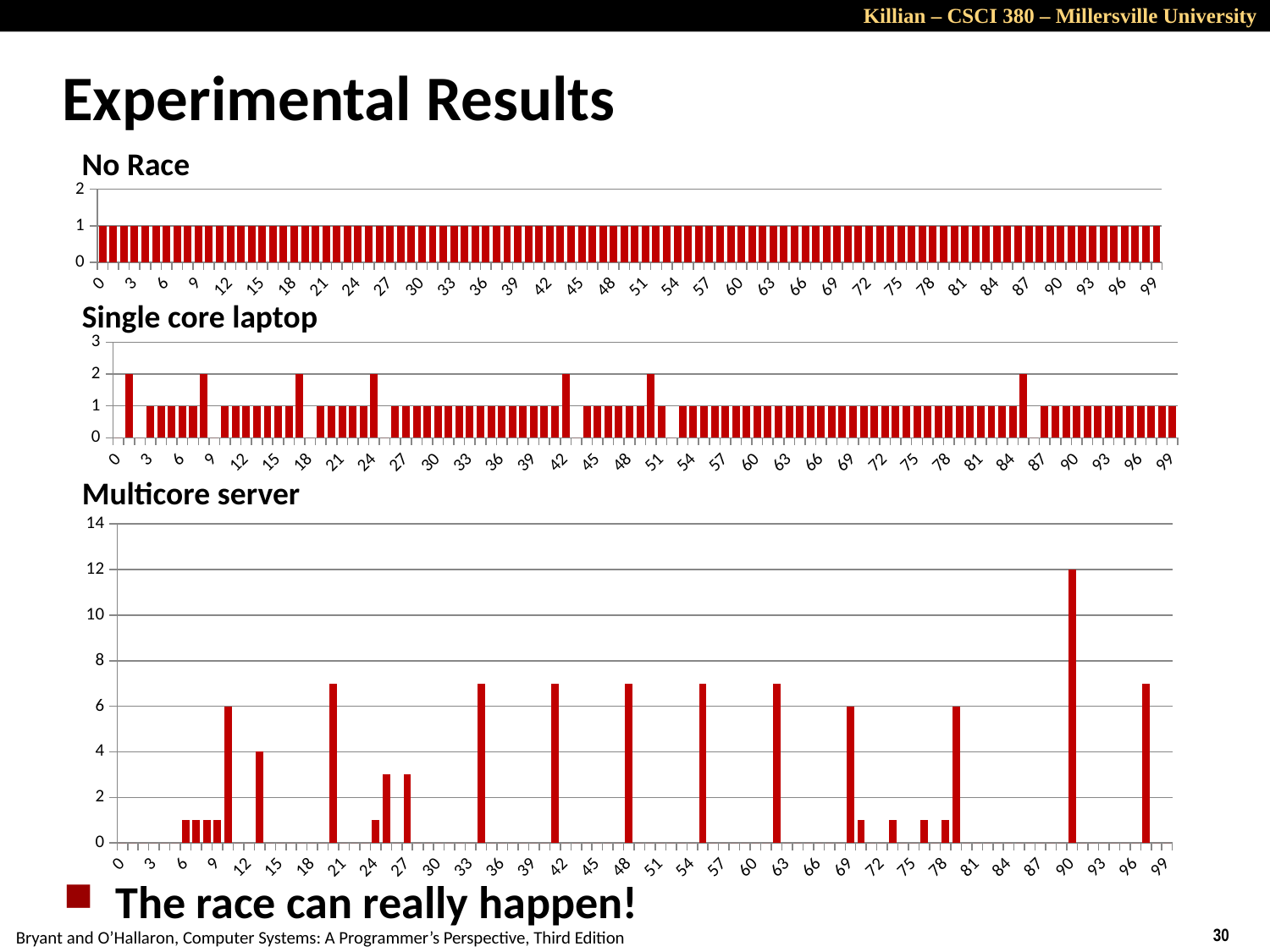
What kind of chart is the Multicore server chart? bar chart What is the title of the bottom chart on the slide? Multicore server Which chart has the larger maximum value, No Race or Multicore server? Multicore server How many charts are shown on the slide? 3 How many categories are plotted along the x axis of the No Race chart (labelled 0 to 99)? 100 In the No Race chart, do the values rise, fall, or stay constant along the x axis? stay constant In the Multicore server chart, what is the value of the bar at category 90? 12 In the No Race chart, what value does every bar reach? 1 In the Multicore server chart, what is the highest value reached by any bar? 12 In the Single core laptop chart, what is the highest value reached by any bar? 2 In the Multicore server chart, is the tallest bar greater or less than 10? greater What is the maximum value shown on the y axis of the Multicore server chart? 14